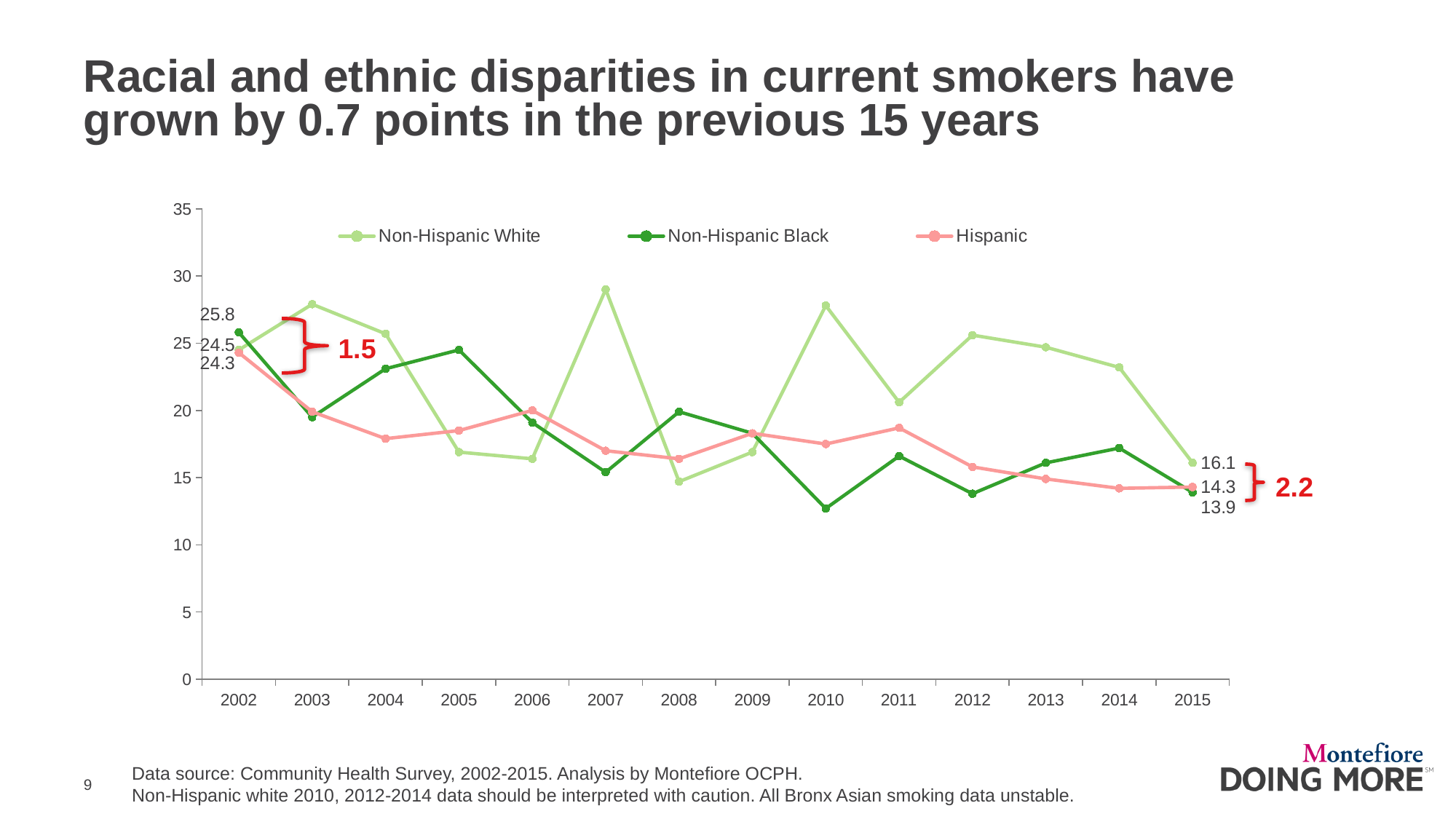
How many years are plotted along the x axis? 14 Which series has the lowest value in 2015? Non-Hispanic Black Is the value for Non-Hispanic White in 2007 greater or less than 25? greater How many series does the legend list? 3 What is the value for Non-Hispanic Black in 2002? 25.8 What is the value for Non-Hispanic Black in 2015? 13.9 Which series has the highest value in 2015? Non-Hispanic White What is the difference between the Non-Hispanic White and Non-Hispanic Black values in 2015? 2.2 What is the value for Non-Hispanic White in 2015? 16.1 What kind of chart is shown on the slide? line chart Is the value for Non-Hispanic Black in 2010 greater or less than 15? less What is the value for Hispanic in 2015? 14.3